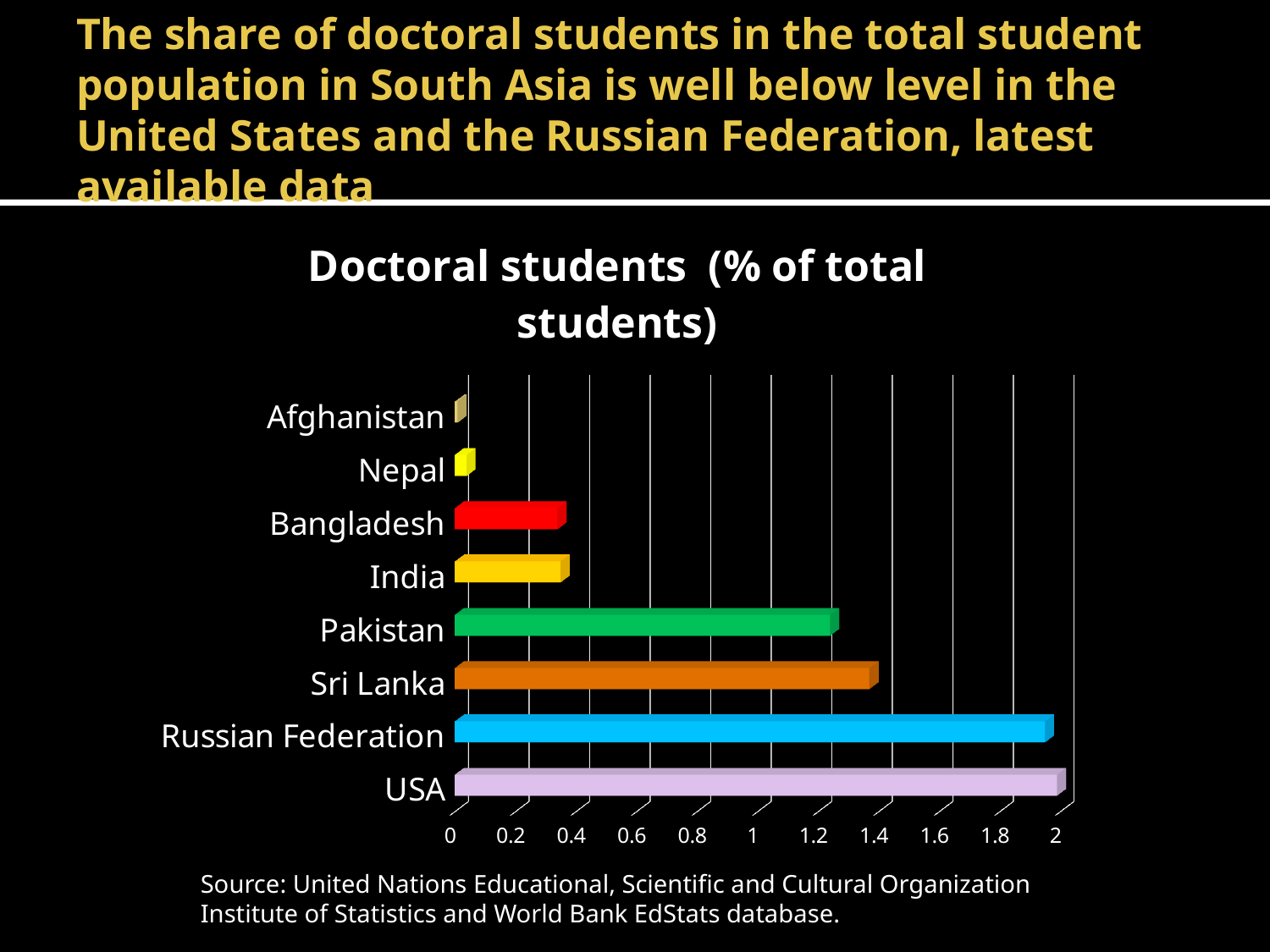
Is the value for the Russian Federation greater or less than 1.8? greater What kind of chart is shown on the slide? bar chart Which has a higher share of doctoral students, the Russian Federation or Sri Lanka? Russian Federation Which has a higher share of doctoral students, Pakistan or India? Pakistan How many countries are shown in the chart? 8 What is the title of the chart? Doctoral students (% of total students) Is the value for Sri Lanka greater or less than 1.6? less Which has a higher share of doctoral students, Sri Lanka or Pakistan? Sri Lanka Is the value for Nepal greater or less than 0.2? less